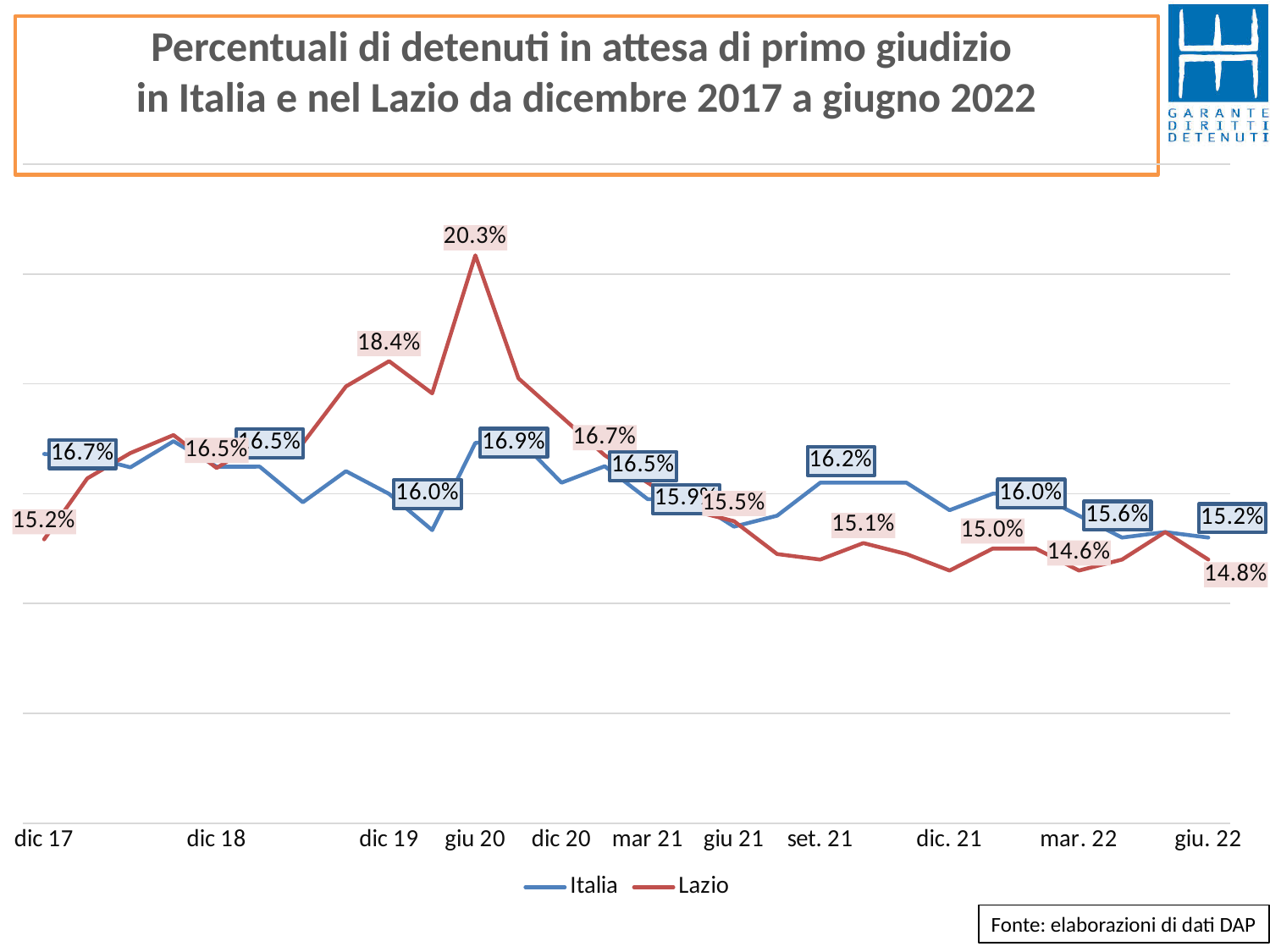
What is the difference between the Italia and Lazio values at giu. 22? 0.4 percentage points How many series does the legend list? 2 Which two series are listed in the legend? Italia and Lazio What is the value for Lazio at giu 20? 20.3% What is the value for Lazio at giu. 22? 14.8% What is the value for Lazio at dic 17? 15.2% Does the Lazio series rise or fall from giu 20 to giu. 22? fall What is the highest labelled value of the Italia series? 16.9% What is the value for Italia at giu. 22? 15.2% What kind of chart is shown on the slide? line chart At giu. 22, which series has the larger value, Italia or Lazio? Italia What is the highest value reached by the Lazio series? 20.3%